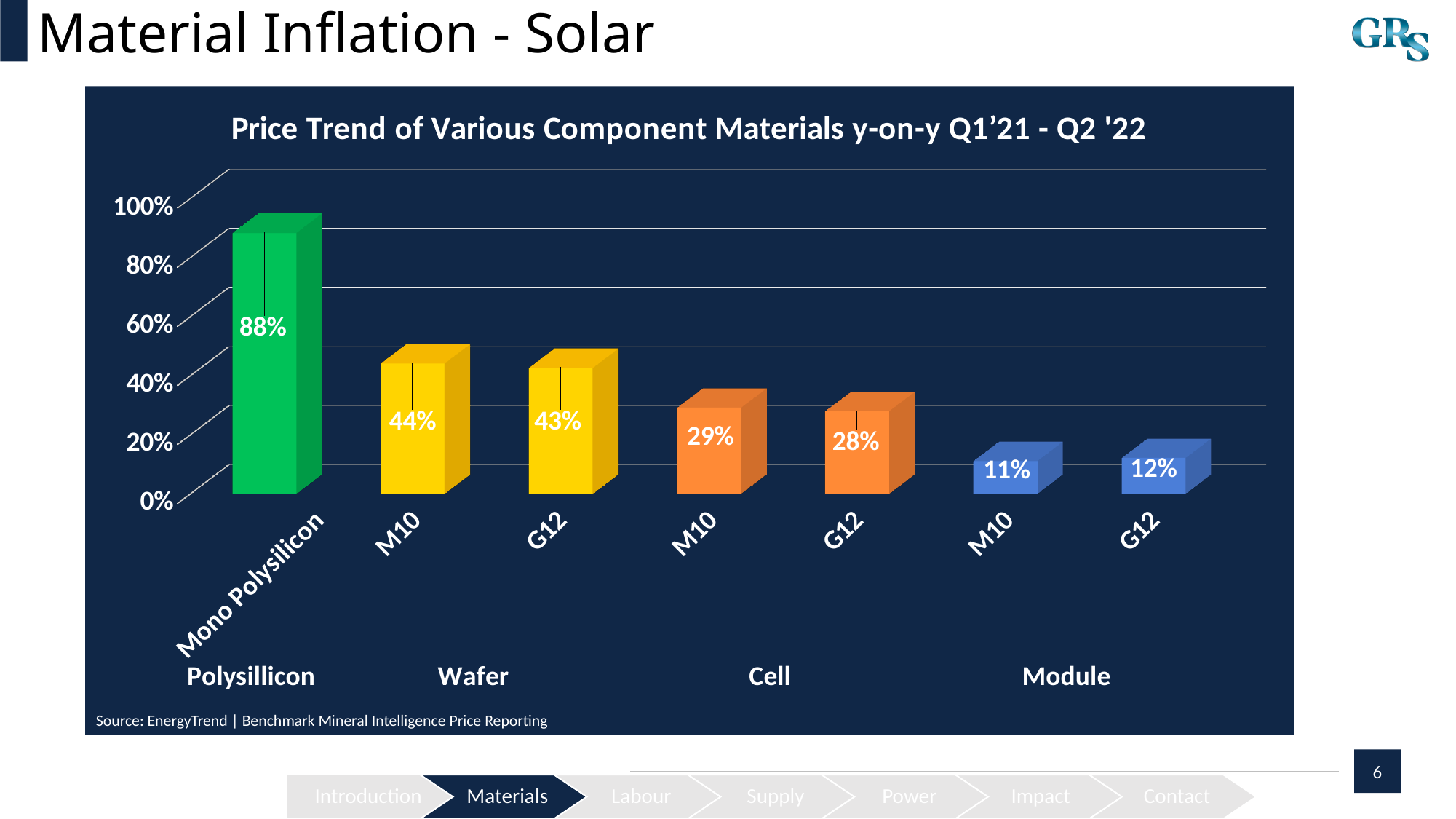
How many bars are plotted in the chart? 7 Which category has the highest value in the chart? Mono Polysilicon What is the difference between the Cell M10 value and the Module M10 value? 18% What is the value shown for the Cell G12 bar? 28% What is the value shown for the Wafer M10 bar? 44% Which bar has the lowest value in the chart? Module M10 Which is larger, the Wafer G12 value or the Cell M10 value? Wafer G12 What kind of chart is shown on the slide? Bar chart What is the value shown for Mono Polysilicon? 88% What is the difference between the Mono Polysilicon value and the Wafer M10 value? 44% What is the title of the chart? Price Trend of Various Component Materials y-on-y Q1'21 - Q2 '22 What is the value shown for the Module M10 bar? 11%